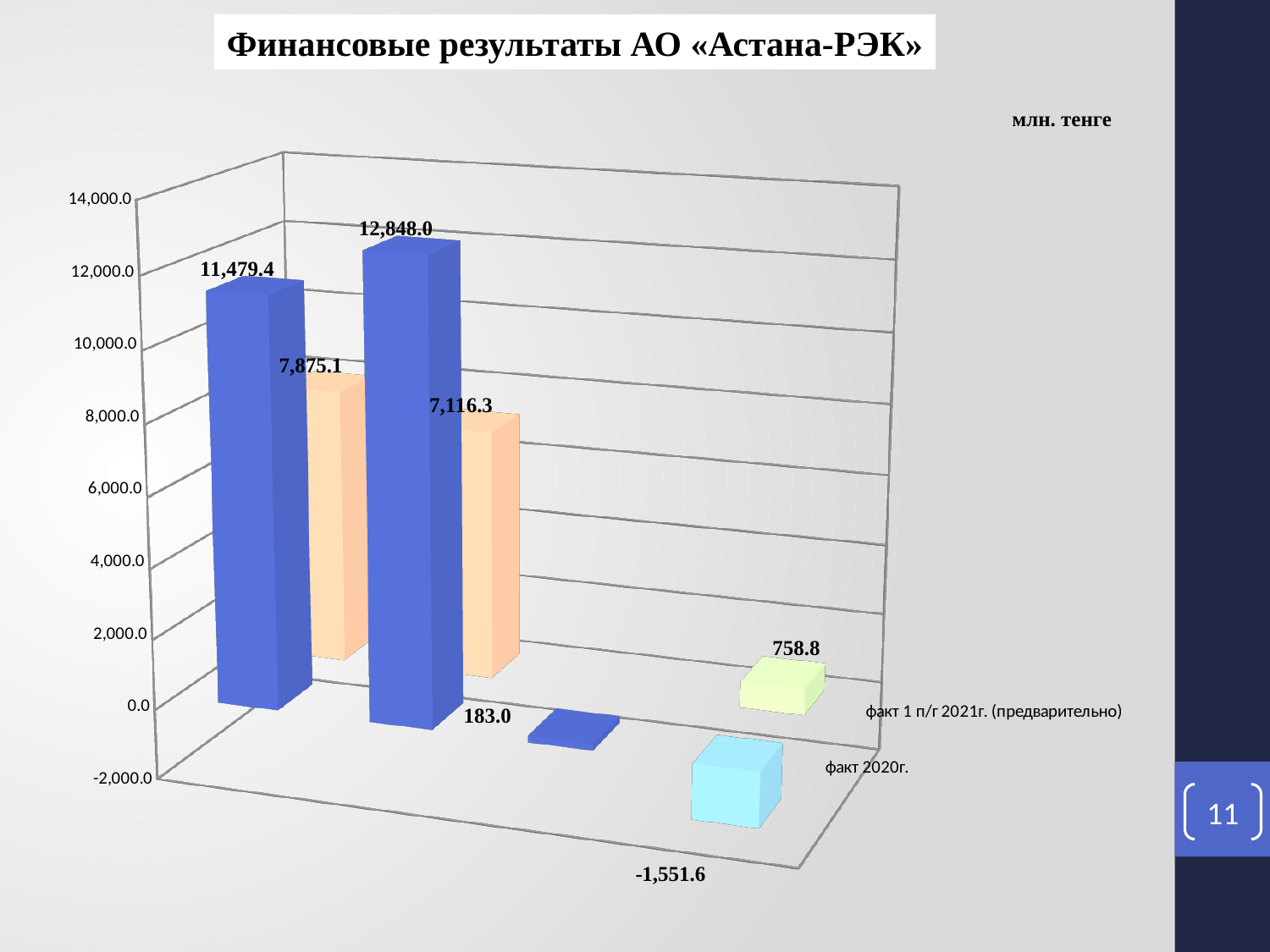
What is the difference between the two tallest bars, 12,848.0 and 11,479.4? 1,368.6 How many series (rows of bars) does the chart show? 2 What unit of measurement is shown for the chart? млн. тенге Which is larger: the bar labelled 11,479.4 or the bar labelled 7,875.1? 11,479.4 What is the value of the leftmost bar in the back row (факт 1 п/г 2021г. (предварительно))? 7,875.1 What is the value of the leftmost bar in the front row (факт 2020г.)? 11,479.4 What kind of chart is shown on the slide? bar chart Is the value of the bar labelled 183.0 greater or less than 2,000.0? less What is the lowest value labelled on the chart? -1,551.6 How many data labels are printed on the chart? 7 What is the highest value labelled on the chart? 12,848.0 What is the title of the chart on the slide? Финансовые результаты АО «Астана-РЭК»